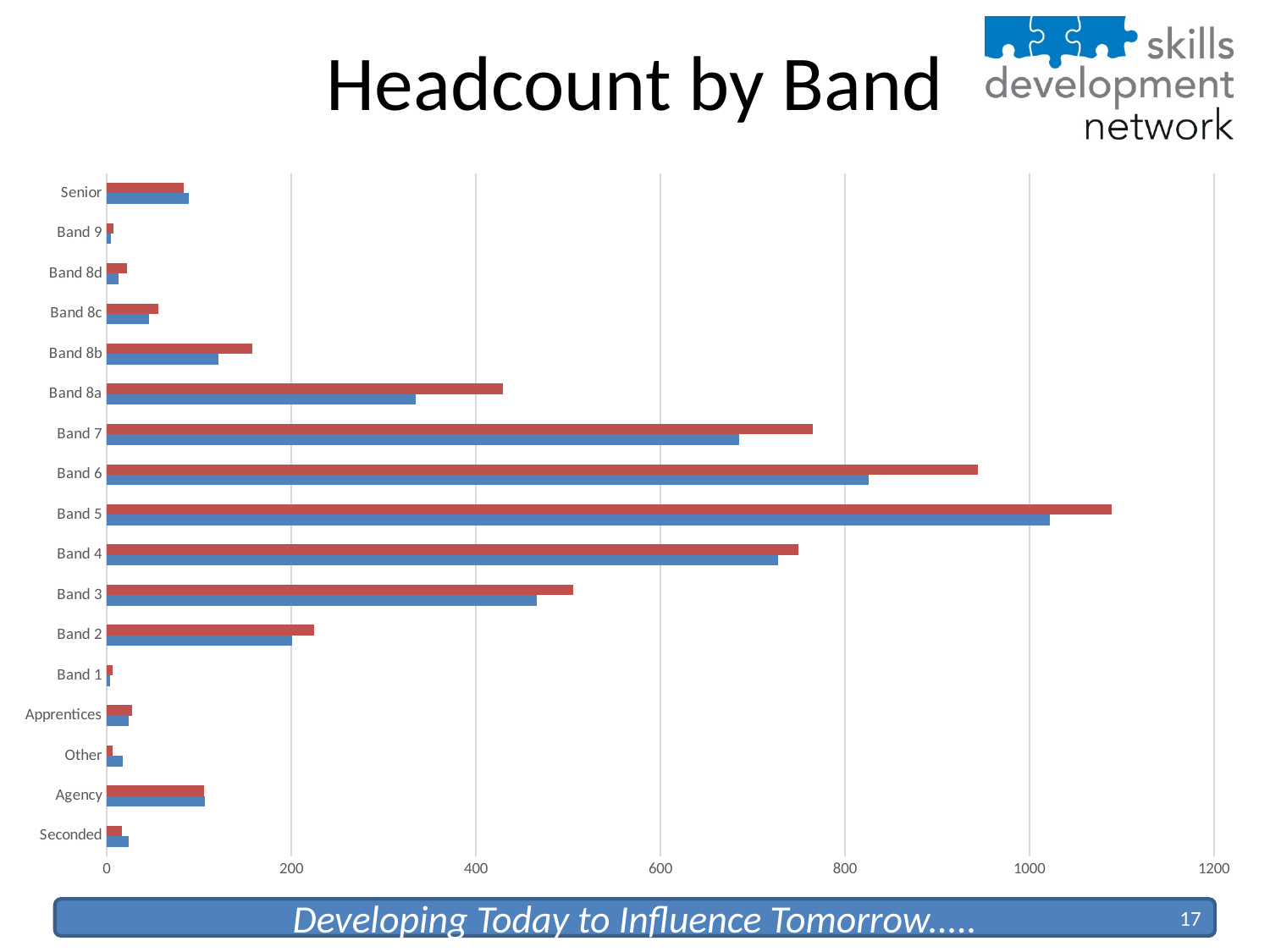
Is the blue bar for Band 7 greater or less than 800? less Is the red bar for Band 6 greater or less than 800? greater For Band 8a, which bar is larger, the red bar or the blue bar? the red bar Is the blue bar for Band 8a greater or less than 400? less Which has the larger red bar, Band 6 or Band 7? Band 6 How many bars are plotted for each category in the chart? 2 What kind of chart is shown on the slide? bar chart What is the title of the chart? Headcount by Band How many categories are listed on the vertical axis of the chart? 17 Which category has the highest headcount in the chart? Band 5